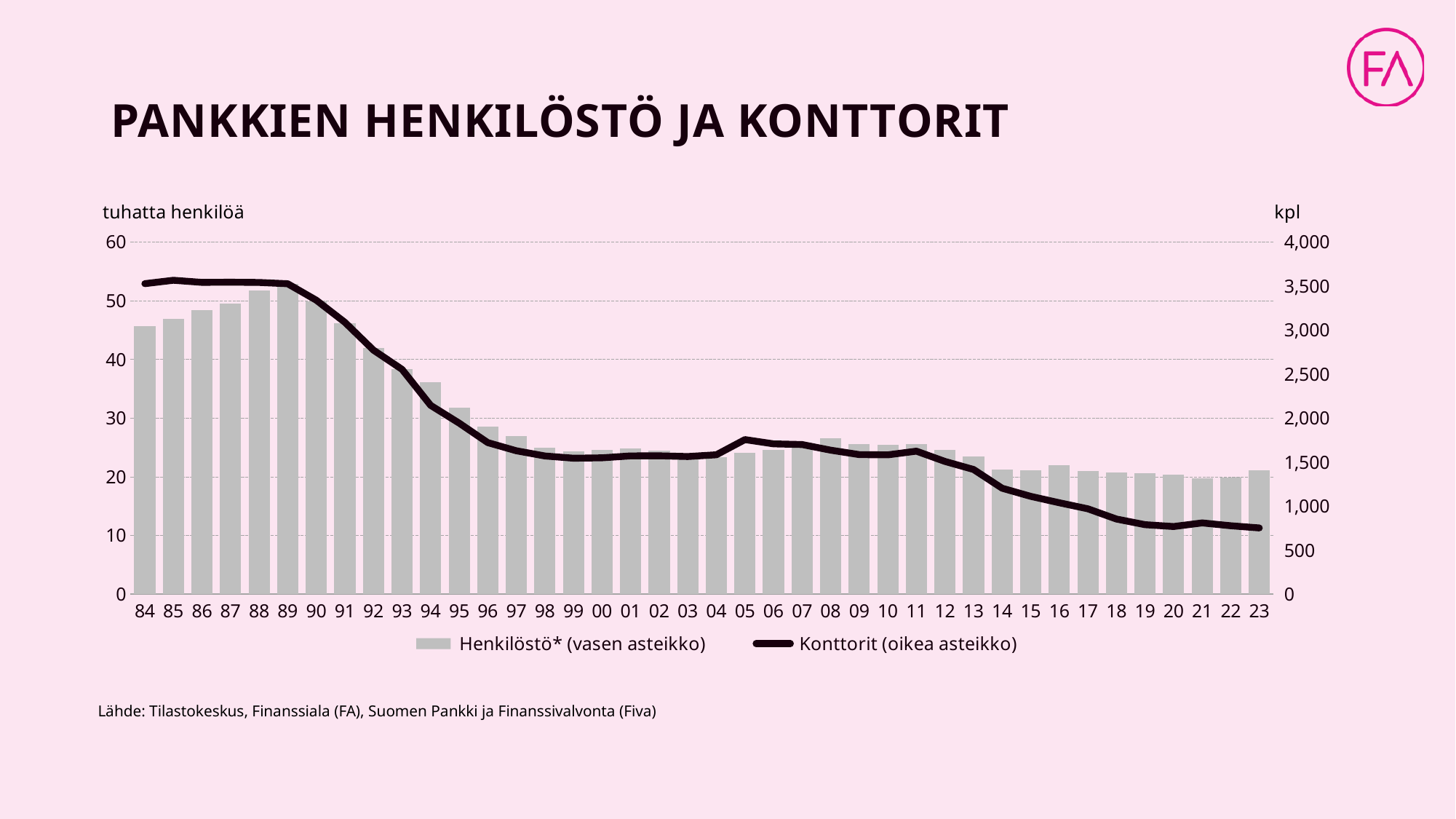
Is the Konttorit value for 14 greater or less than 1,500? less Is the Henkilöstö value for 94 greater or less than 40? less Which series is plotted on the right-hand axis according to the legend? Konttorit (oikea asteikko) Is the Konttorit value for 84 greater or less than 3,000? greater How many years are shown on the x axis? 40 How many series does the legend list? 2 What is the title of the chart? PANKKIEN HENKILÖSTÖ JA KONTTORIT Which year has the larger Henkilöstö value, 95 or 05? 95 What kind of chart is shown on the slide? A combined bar and line chart Does the Konttorit line generally rise or fall from 89 to 23? Fall